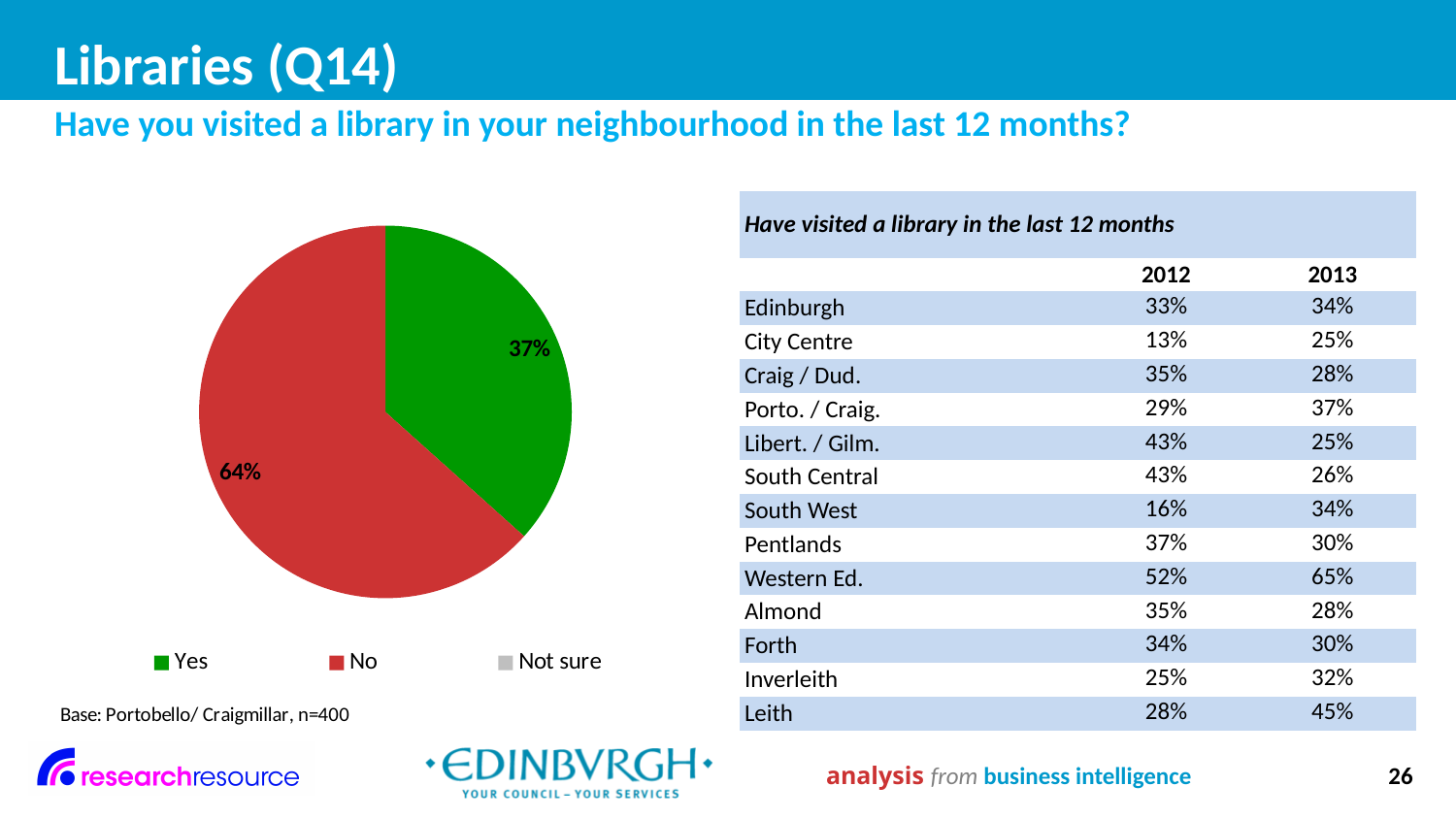
What percentage of respondents answered Yes in the pie chart? 37% What is the base stated beneath the pie chart? Portobello/ Craigmillar, n=400 Is the No slice in the pie chart greater or less than 50%? greater What type of chart is shown on the left of the slide? Pie chart What percentage of respondents answered No in the pie chart? 64% Which is larger in the pie chart, the Yes slice or the No slice? No What colour represents the Yes response in the pie chart? Green How many entries does the legend of the pie chart list? 3 Which response has the largest slice in the pie chart? No Is the Yes slice in the pie chart greater or less than 50%? less What is the difference in percentage points between the No and Yes slices in the pie chart? 27 percentage points How many slices in the pie chart have a percentage label printed on them? 2